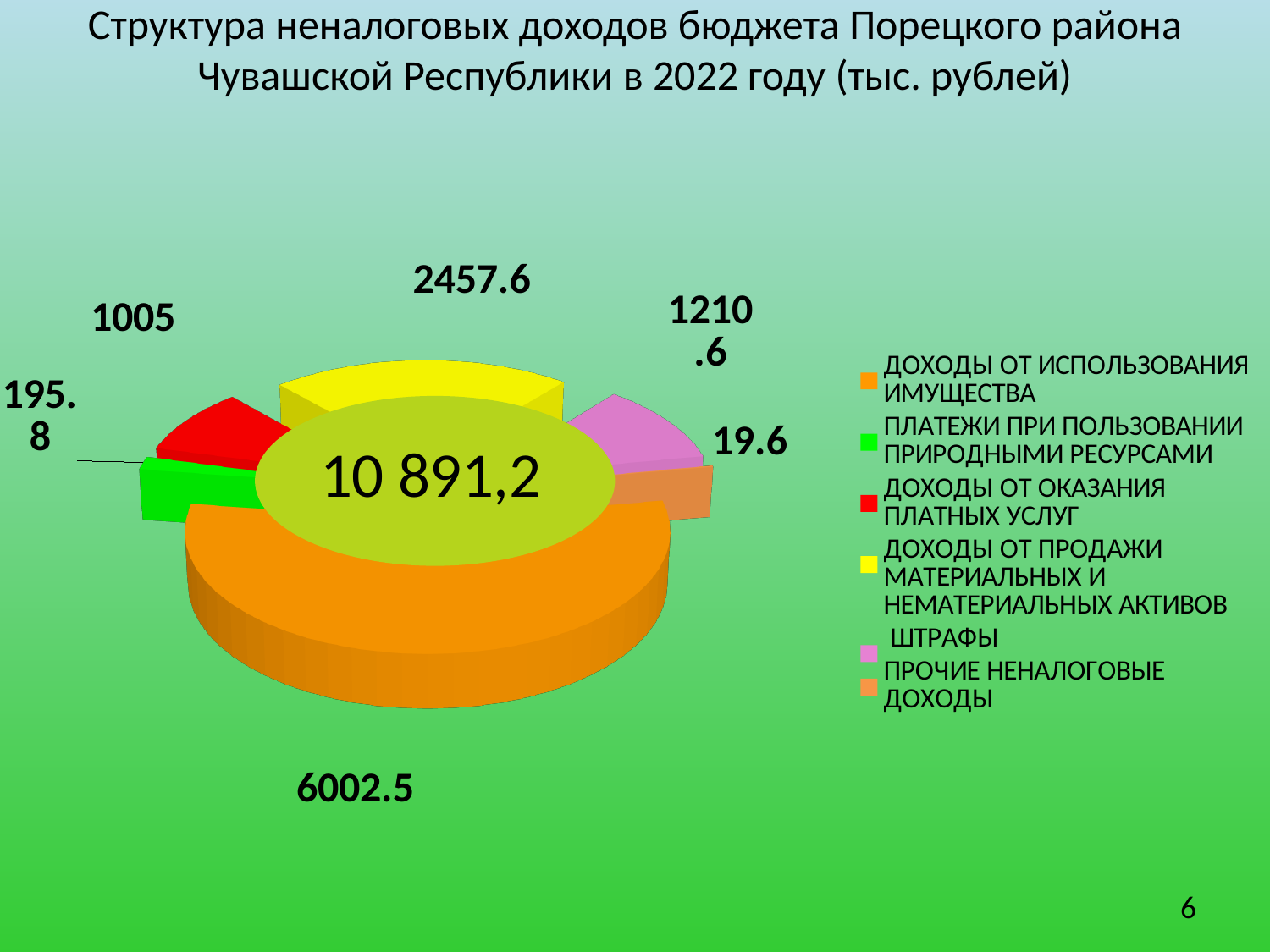
Which is larger: the value for ДОХОДЫ ОТ ОКАЗАНИЯ ПЛАТНЫХ УСЛУГ or the value for ШТРАФЫ? ШТРАФЫ What is the value for ДОХОДЫ ОТ ПРОДАЖИ МАТЕРИАЛЬНЫХ И НЕМАТЕРИАЛЬНЫХ АКТИВОВ? 2457.6 Which category has the largest slice of the pie? ДОХОДЫ ОТ ИСПОЛЬЗОВАНИЯ ИМУЩЕСТВА What is the value for ПРОЧИЕ НЕНАЛОГОВЫЕ ДОХОДЫ? 19.6 What is the value for ДОХОДЫ ОТ ИСПОЛЬЗОВАНИЯ ИМУЩЕСТВА? 6002.5 Which category has the smallest slice of the pie? ПРОЧИЕ НЕНАЛОГОВЫЕ ДОХОДЫ What is the value for ПЛАТЕЖИ ПРИ ПОЛЬЗОВАНИИ ПРИРОДНЫМИ РЕСУРСАМИ? 195.8 How many categories does the pie chart have? 6 What is the value for ШТРАФЫ? 1210.6 What type of chart is shown on the slide? Pie chart What is the difference between the values for ДОХОДЫ ОТ ИСПОЛЬЗОВАНИЯ ИМУЩЕСТВА and ДОХОДЫ ОТ ПРОДАЖИ МАТЕРИАЛЬНЫХ И НЕМАТЕРИАЛЬНЫХ АКТИВОВ? 3544.9 What total value is printed in the centre of the pie chart? 10 891,2